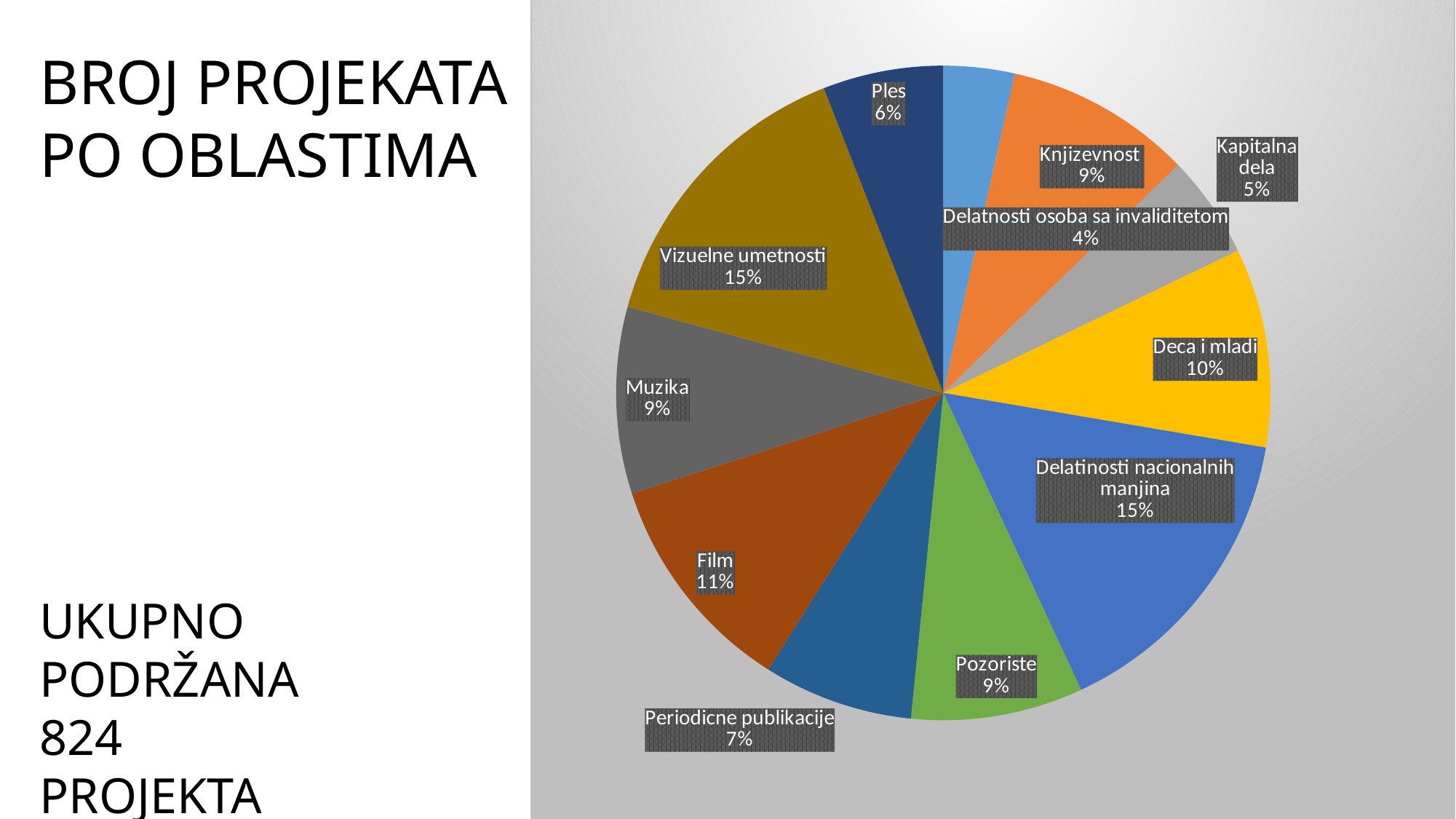
What percentage is shown for Vizuelne umetnosti? 15% What percentage is shown for Kapitalna dela? 5% Which has a larger share, Deca i mladi or Knjizevnost? Deca i mladi What share of the pie does Film represent? 11% Which category has the smallest share of the pie? Delatnosti osoba sa invaliditetom What is the combined share of Muzika and Pozoriste? 18% What is the difference in percentage points between Film and Ples? 5 What percentage is shown for Periodicne publikacije? 7% How many slices does the pie chart have? 11 What is the title of the slide containing the pie chart? BROJ PROJEKATA PO OBLASTIMA What kind of chart is shown on the slide? pie chart What percentage is shown for Deca i mladi? 10%